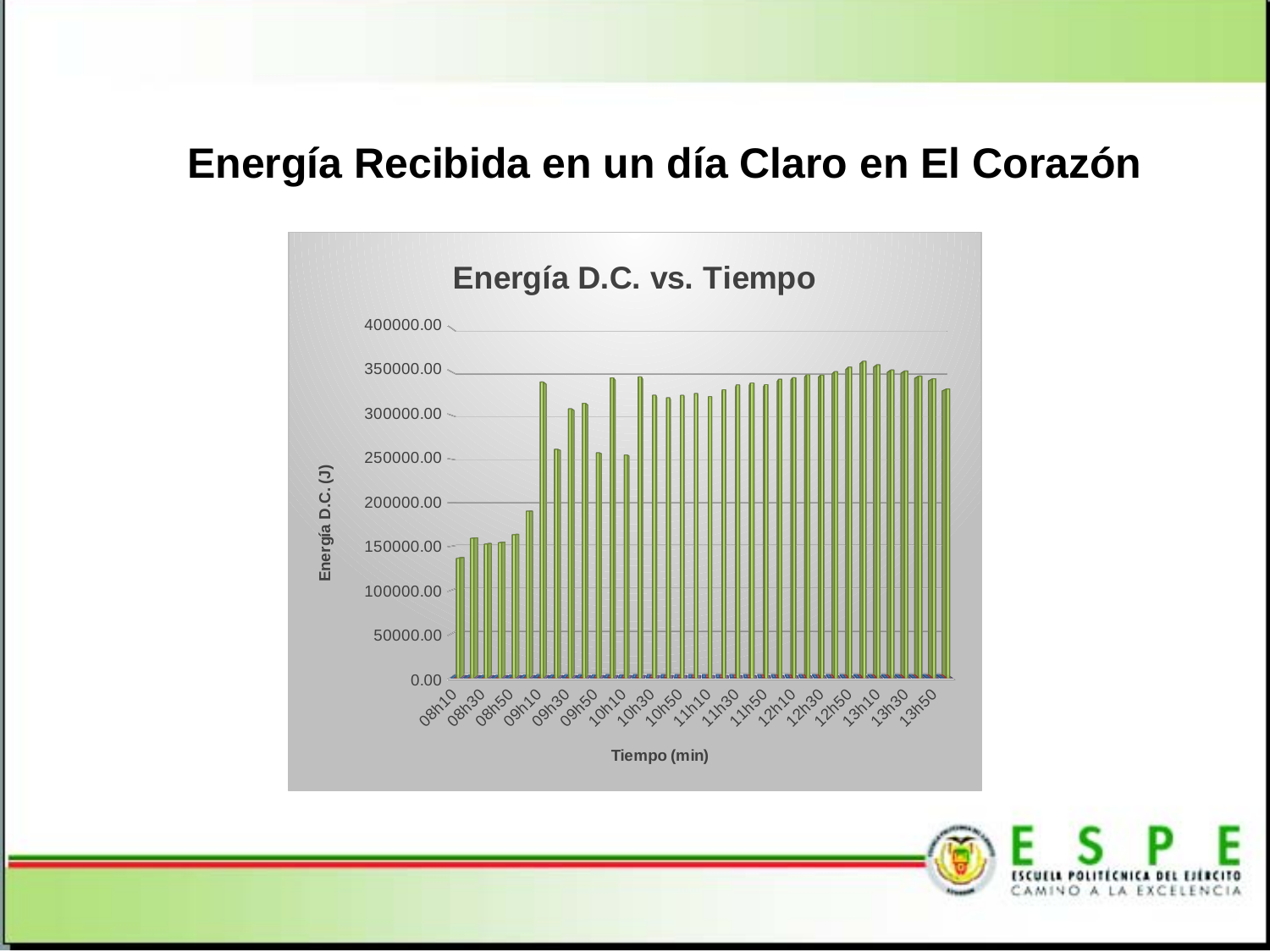
What kind of chart is shown on the slide? bar chart Is the value for 08h10 greater or less than 150000.00? less Is the value for 08h50 greater or less than 200000.00? less Which has a larger value, 08h10 or 13h50? 13h50 What is the label of the vertical axis of the chart? Energía D.C. (J) Is the value for 12h50 greater or less than 300000.00? greater Do the values generally rise or fall from 08h10 to 13h50? rise How many time labels are shown on the x axis of the chart? 18 What is the title of the chart? Energía D.C. vs. Tiempo Which time has the lowest energy value in the chart? 08h10